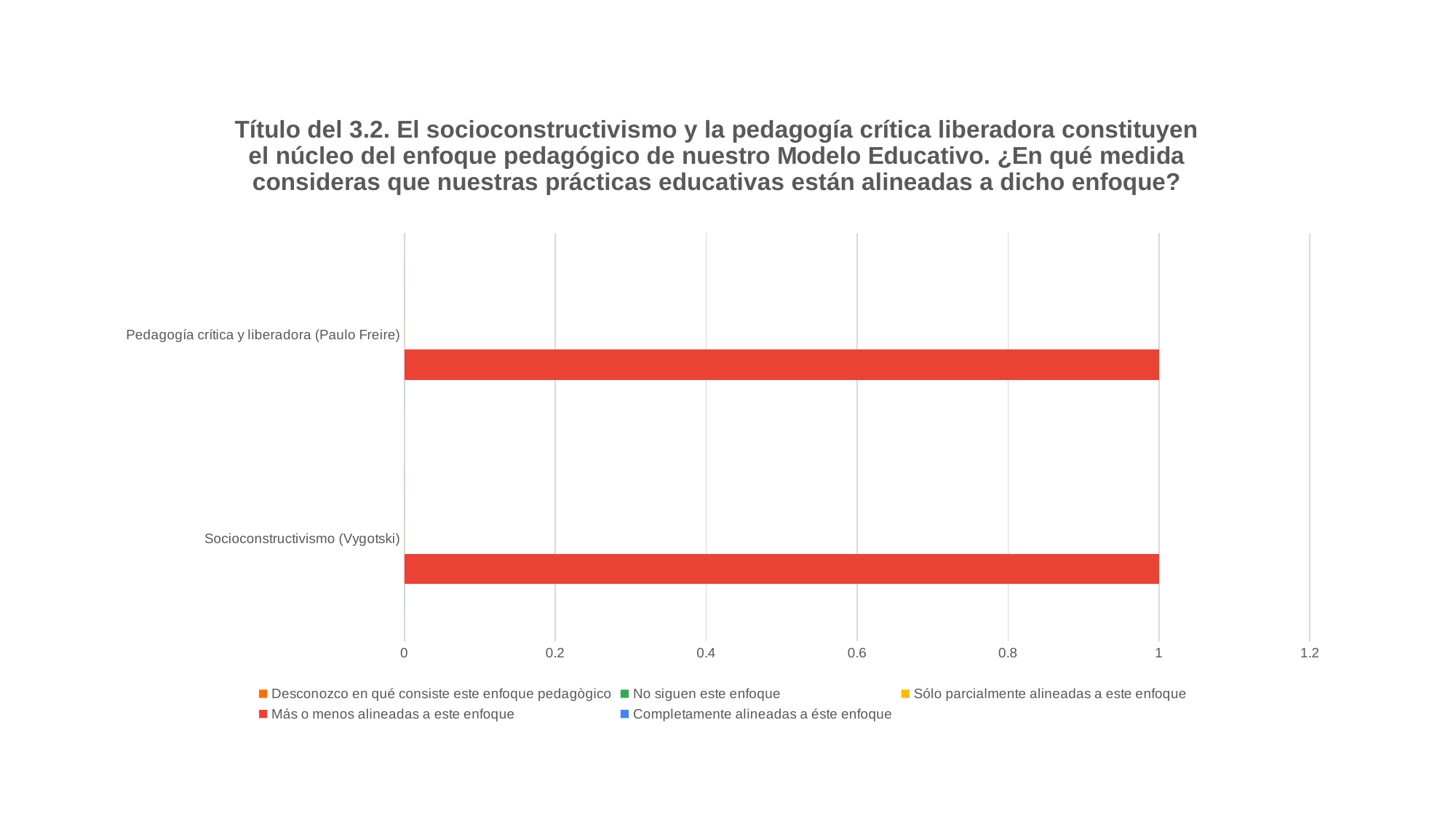
What is the value of the 'Más o menos alineadas a este enfoque' bar for 'Pedagogía crítica y liberadora (Paulo Freire)'? 1 How many categories are plotted on the vertical axis? 2 What colour is used for the 'Más o menos alineadas a este enfoque' series in the legend? red What kind of chart is shown on the slide? bar chart What is the highest tick value shown on the horizontal axis? 1.2 Which legend series is the only one with visible bars in the chart? Más o menos alineadas a este enfoque What is the value of the 'Más o menos alineadas a este enfoque' bar for 'Socioconstructivismo (Vygotski)'? 1 How many series does the legend list? 5 Is the value of the red bar for 'Pedagogía crítica y liberadora (Paulo Freire)' greater or less than 0.6? greater Is the value of the red bar for 'Socioconstructivismo (Vygotski)' greater or less than 0.8? greater